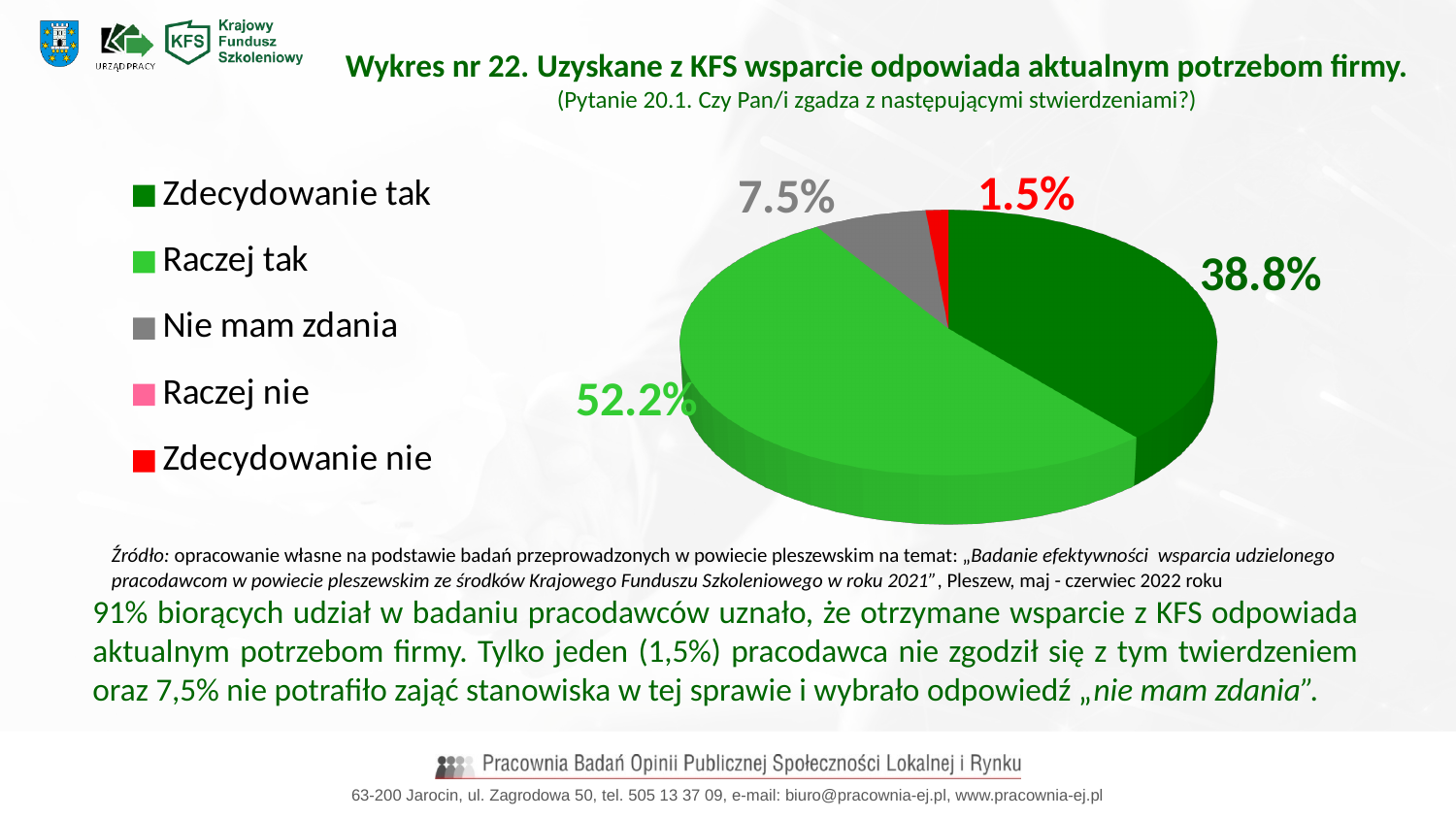
What share of the pie does "Zdecydowanie nie" have? 1.5% What share of the pie does "Raczej tak" have? 52.2% Which is larger, the share for "Nie mam zdania" or the share for "Zdecydowanie nie"? Nie mam zdania What is the difference between the shares for "Raczej tak" and "Zdecydowanie tak"? 13.4 percentage points How many entries does the legend list? 5 What colour is the slice for "Nie mam zdania"? grey What kind of chart is shown on the slide? pie chart What is the combined share of "Zdecydowanie tak" and "Raczej tak"? 91% Which labelled slice of the pie is the smallest? Zdecydowanie nie What share of the pie does "Zdecydowanie tak" have? 38.8% Which category has the largest slice of the pie? Raczej tak What share of the pie does "Nie mam zdania" have? 7.5%